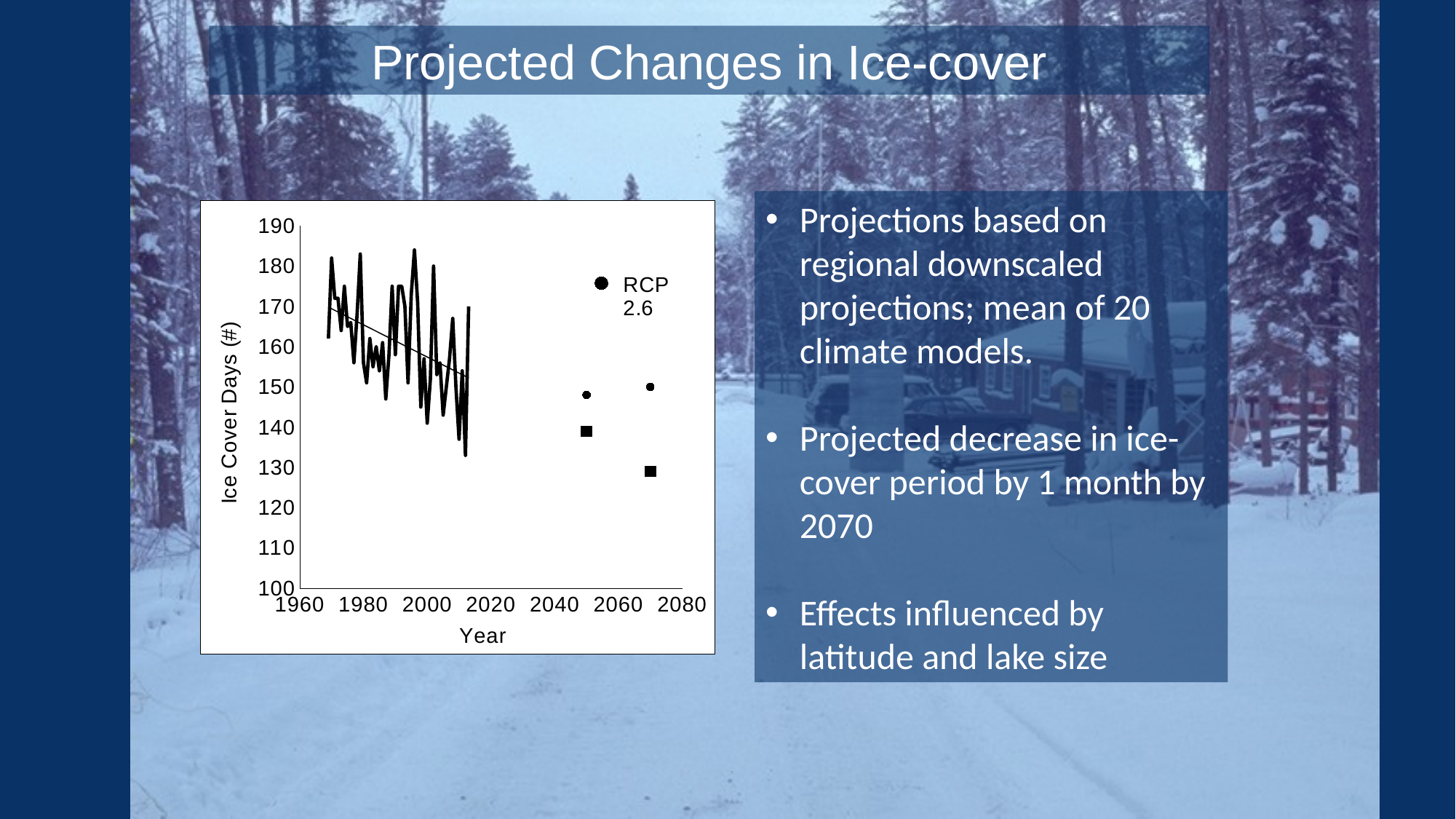
What is the label of the x axis of the chart? Year Is the square projected value near 2070 greater or less than 140 ice cover days? less What kind of chart is shown on the slide? line chart Is the highest value of the historical ice cover days line greater or less than 180? greater Near 2070, which projected point is higher: the circle (RCP 2.6) or the square? the circle (RCP 2.6) Is the square projected value near 2050 greater or less than 150 ice cover days? less Which square projected point is higher: the one near 2050 or the one near 2070? the one near 2050 Does the historical ice cover days line rise or fall over time from 1970 to about 2013? fall What is the label of the y axis of the chart? Ice Cover Days (#)